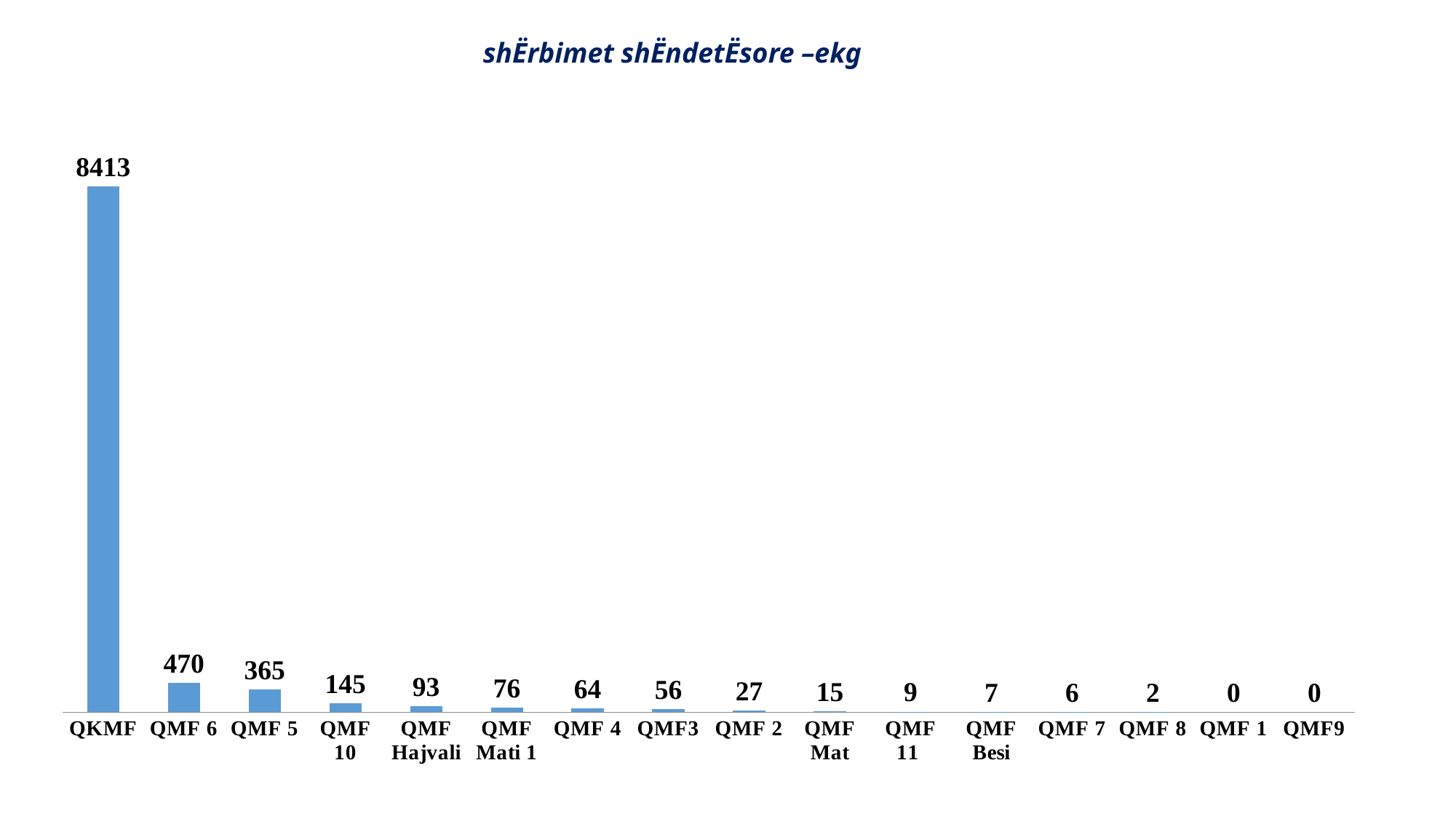
What is the difference between the values for QMF 6 and QMF 5? 105 How many categories are shown on the x axis? 16 What kind of chart is shown on the slide? bar chart What is the value for QKMF? 8413 Do the values rise or fall from left to right along the x axis? fall Which category has the highest value? QKMF Which is larger, the value for QMF 10 or the value for QMF Mati 1? QMF 10 What is the title of the chart? shËrbimet shËndetËsore –ekg What is the value for QMF 2? 27 Which categories have a value of 0? QMF 1 and QMF9 What is the value for QMF Besi? 7 What is the value for QMF Hajvali? 93